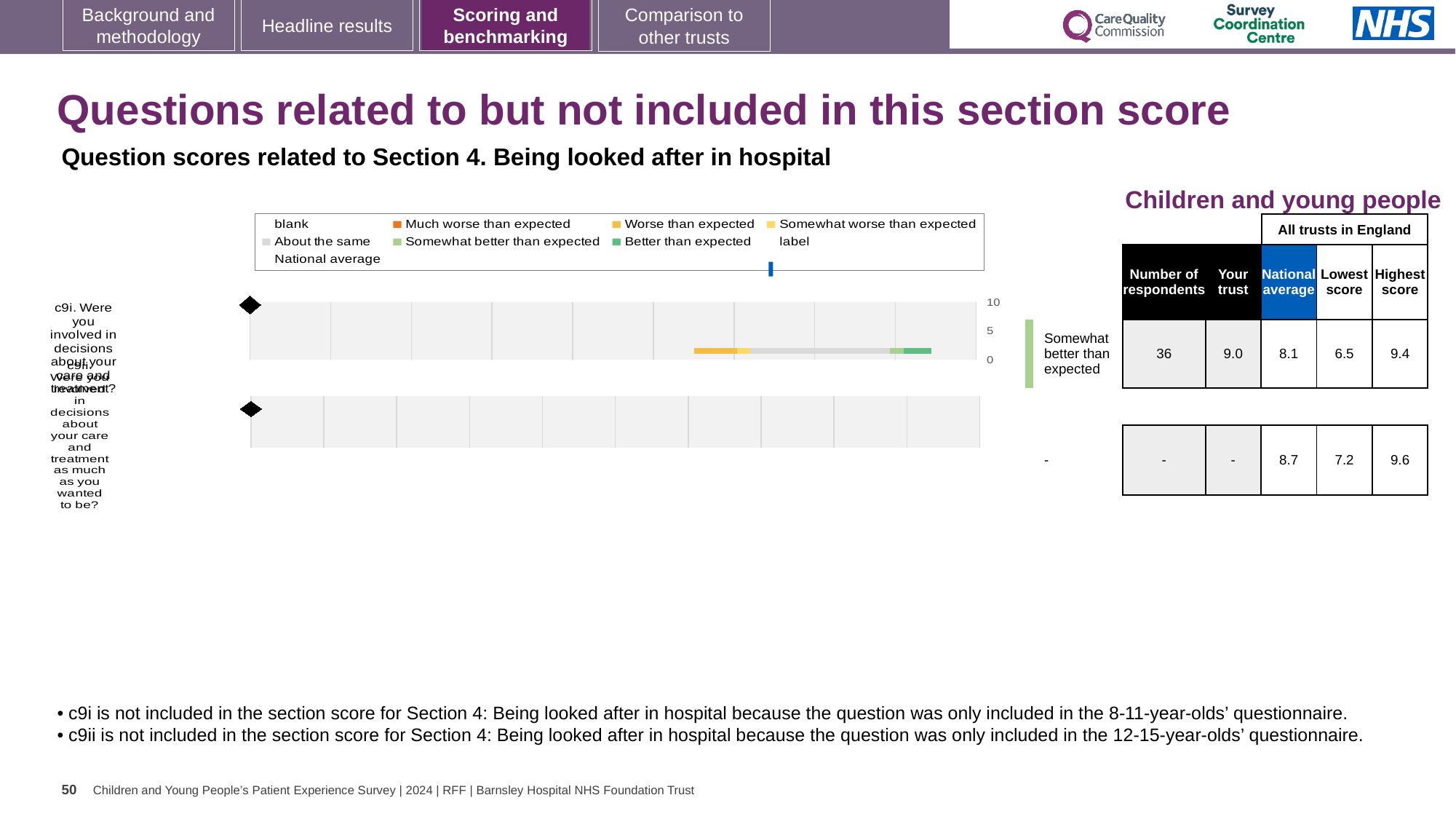
What kind of chart is shown on the slide? bar chart According to the label next to the chart, which benchmark category does the trust fall into for question c9i? Somewhat better than expected By how much does the trust's score for c9i exceed the national average? 0.9 In the table, what is the number of respondents for question c9i? 36 How many questions (rows) are plotted in the chart? 2 In the table, what is the highest score across all trusts in England for question c9i? 9.4 Is the trust's score for c9i higher or lower than the national average? higher In the table, what is the lowest score across all trusts in England for question c9ii? 7.2 In the table, what is the 'Your trust' score for question c9i? 9.0 What is the highest value shown on the chart's numeric axis? 10 What is the difference between the highest and lowest scores for question c9ii? 2.4 In the table, what is the national average for question c9i? 8.1